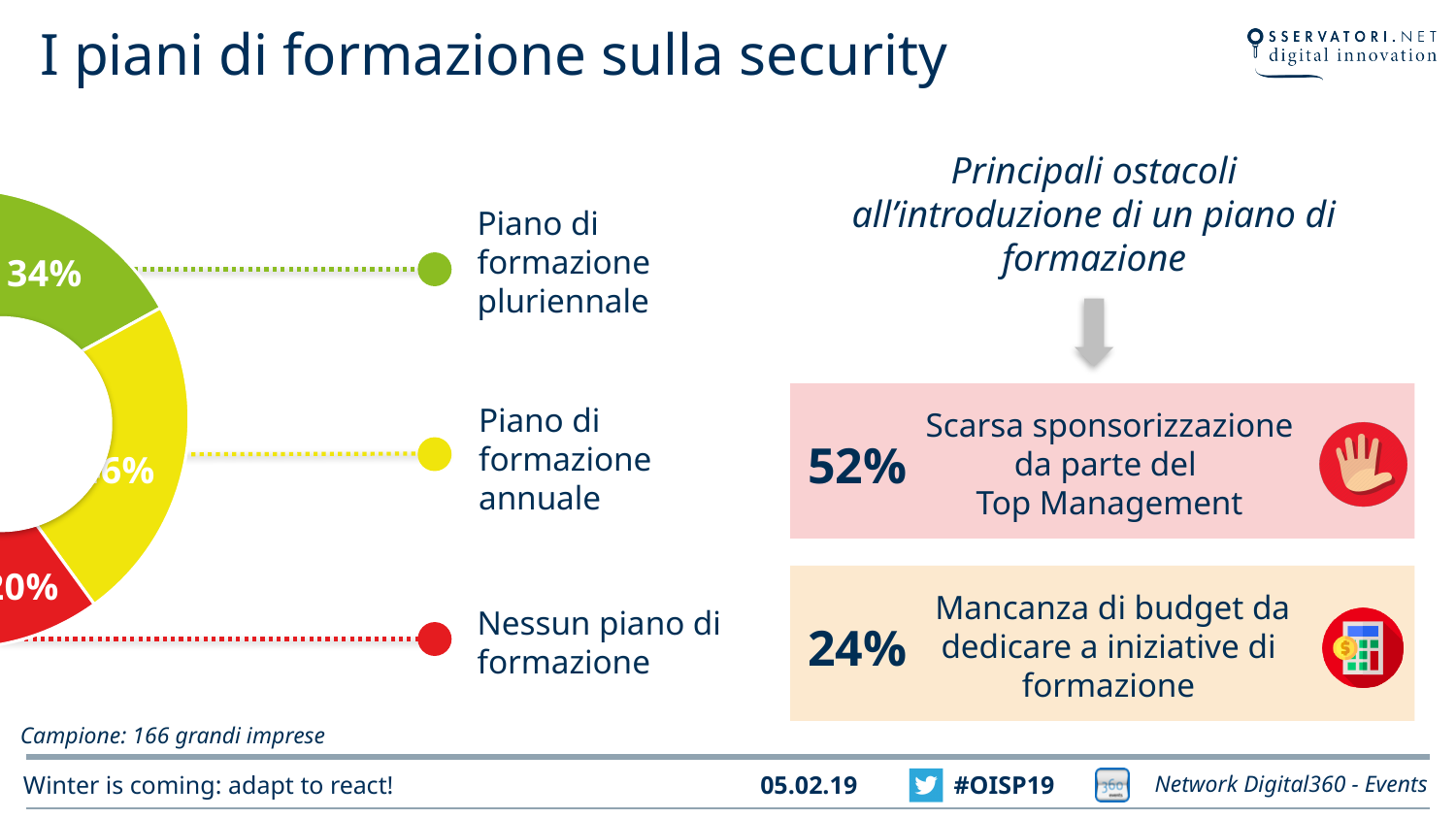
What kind of chart is shown on the left of the slide? donut chart Which category has the smallest slice in the donut chart? Nessun piano di formazione In the donut chart, which is larger: 'Piano di formazione pluriennale' or 'Nessun piano di formazione'? Piano di formazione pluriennale What colour is the 'Piano di formazione pluriennale' slice in the donut chart? green How many categories does the donut chart show? 3 According to the note below the chart, how many large companies make up the sample? 166 Which category has the largest slice in the donut chart? Piano di formazione annuale In the donut chart, which is larger: 'Piano di formazione annuale' or 'Piano di formazione pluriennale'? Piano di formazione annuale What percentage of the donut chart corresponds to 'Piano di formazione pluriennale'? 34%